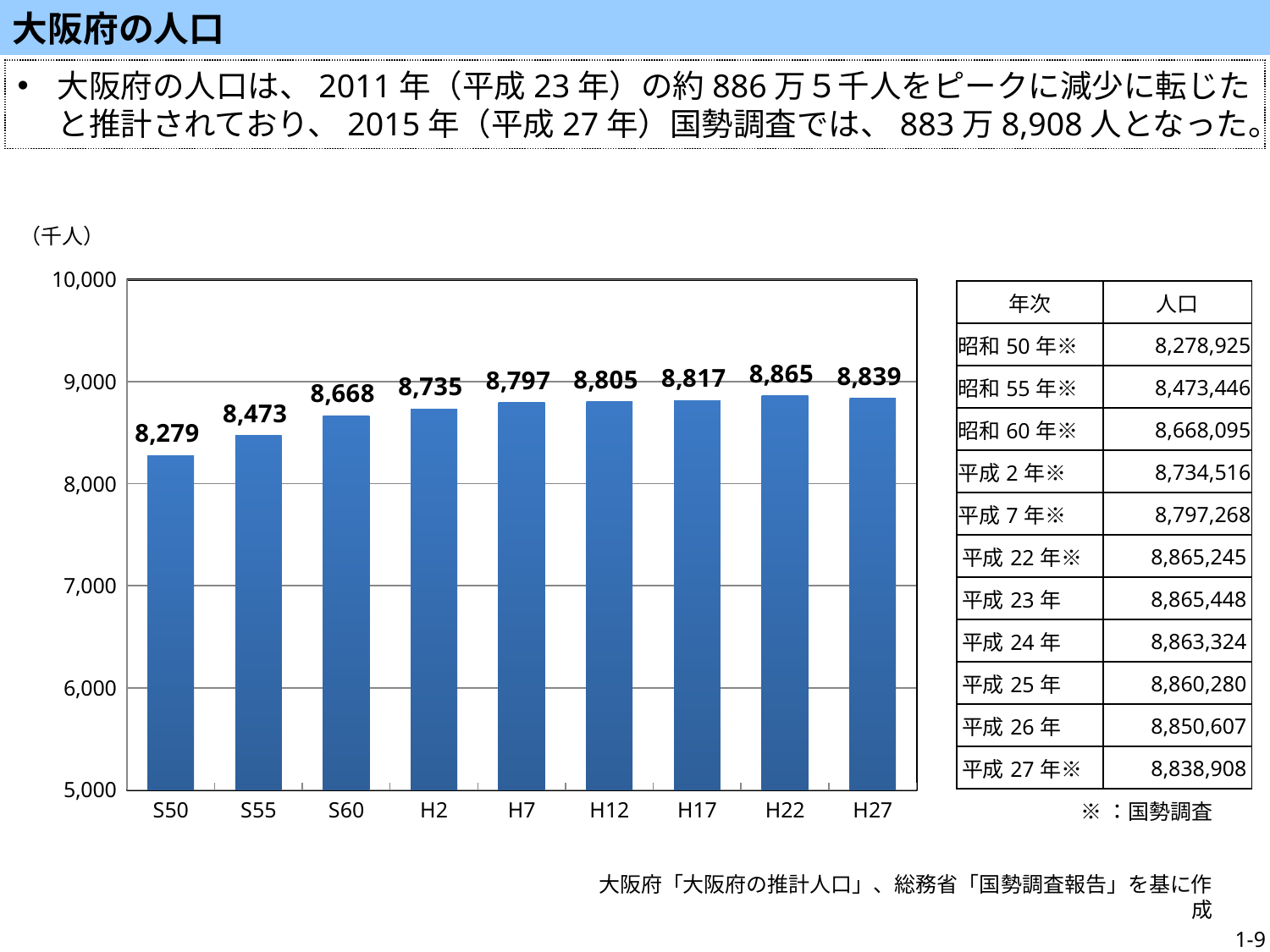
Is the value for H7 greater or less than 9,000? less What unit is indicated above the chart's y axis? （千人） Which is larger, the value for S60 or the value for H2? H2 What is the value for S50 in the bar chart? 8,279 Which category has the highest value in the bar chart? H22 What is the value for H22 in the bar chart? 8,865 What is the difference between the values for H22 and H27? 26 Which category has the lowest value in the bar chart? S50 What is the difference between the values for S55 and S50? 194 How many categories are shown on the x axis of the bar chart? 9 What is the value for H27 in the bar chart? 8,839 What kind of chart is shown on the slide? bar chart